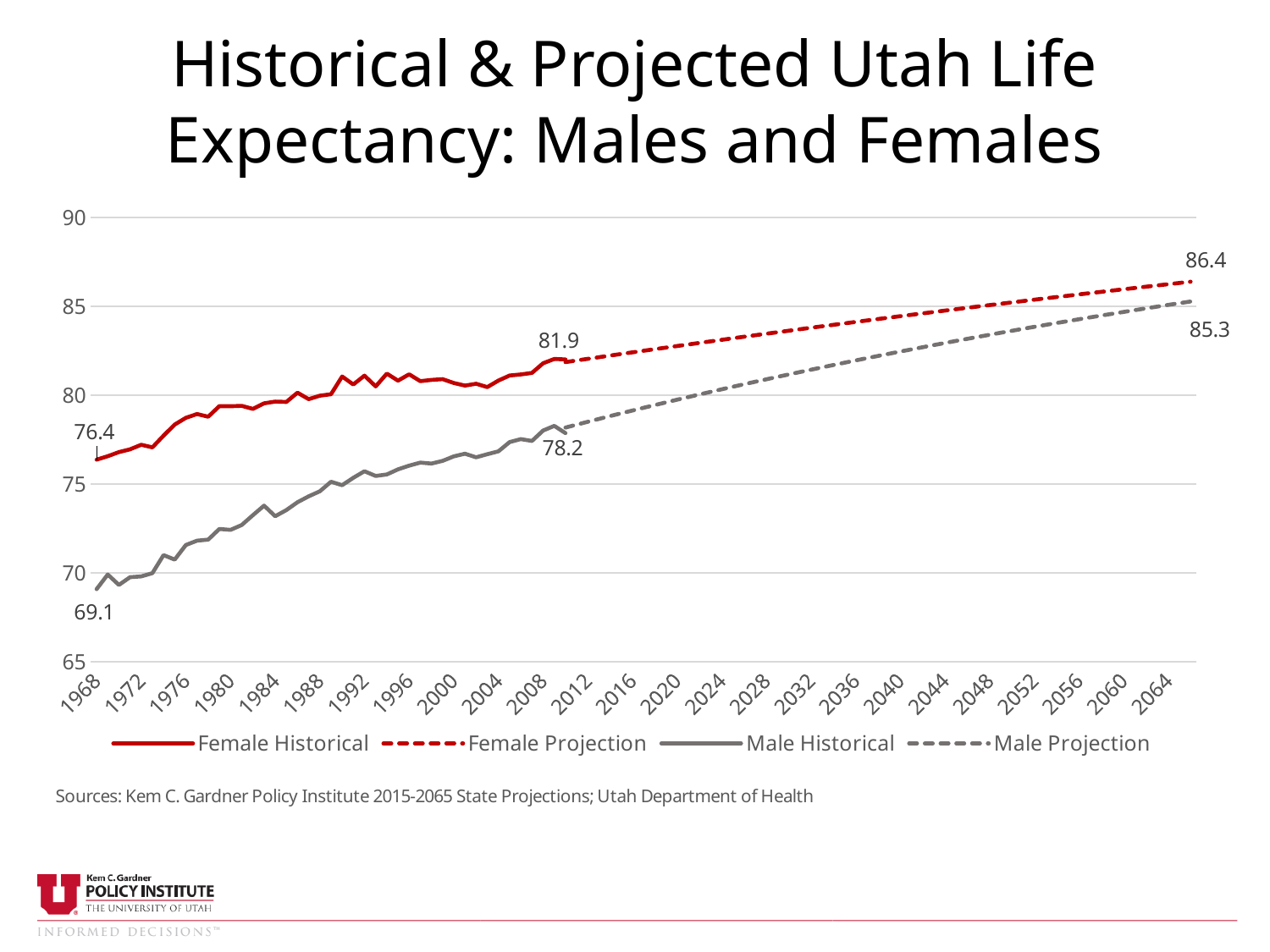
What is the value labeled at the end of the Female Historical line? 81.9 What is the difference between the final projected female value (86.4) and the final projected male value (85.3)? 1.1 What is the female life expectancy value labeled at the start of the Female Historical line in 1968? 76.4 What kind of chart is shown on the slide? line chart What is the projected female life expectancy at the end of the Female Projection line? 86.4 What is the value labeled at the end of the Male Historical line? 78.2 How many series does the legend list? 4 What is the difference between the 1968 female value (76.4) and the 1968 male value (69.1)? 7.3 What is the projected male life expectancy at the end of the Male Projection line? 85.3 What is the male life expectancy value labeled at the start of the Male Historical line in 1968? 69.1 Which is larger in 1968, the female life expectancy or the male life expectancy? female Does the Male Historical line rise or fall from 1968 to the end of the historical period? rise